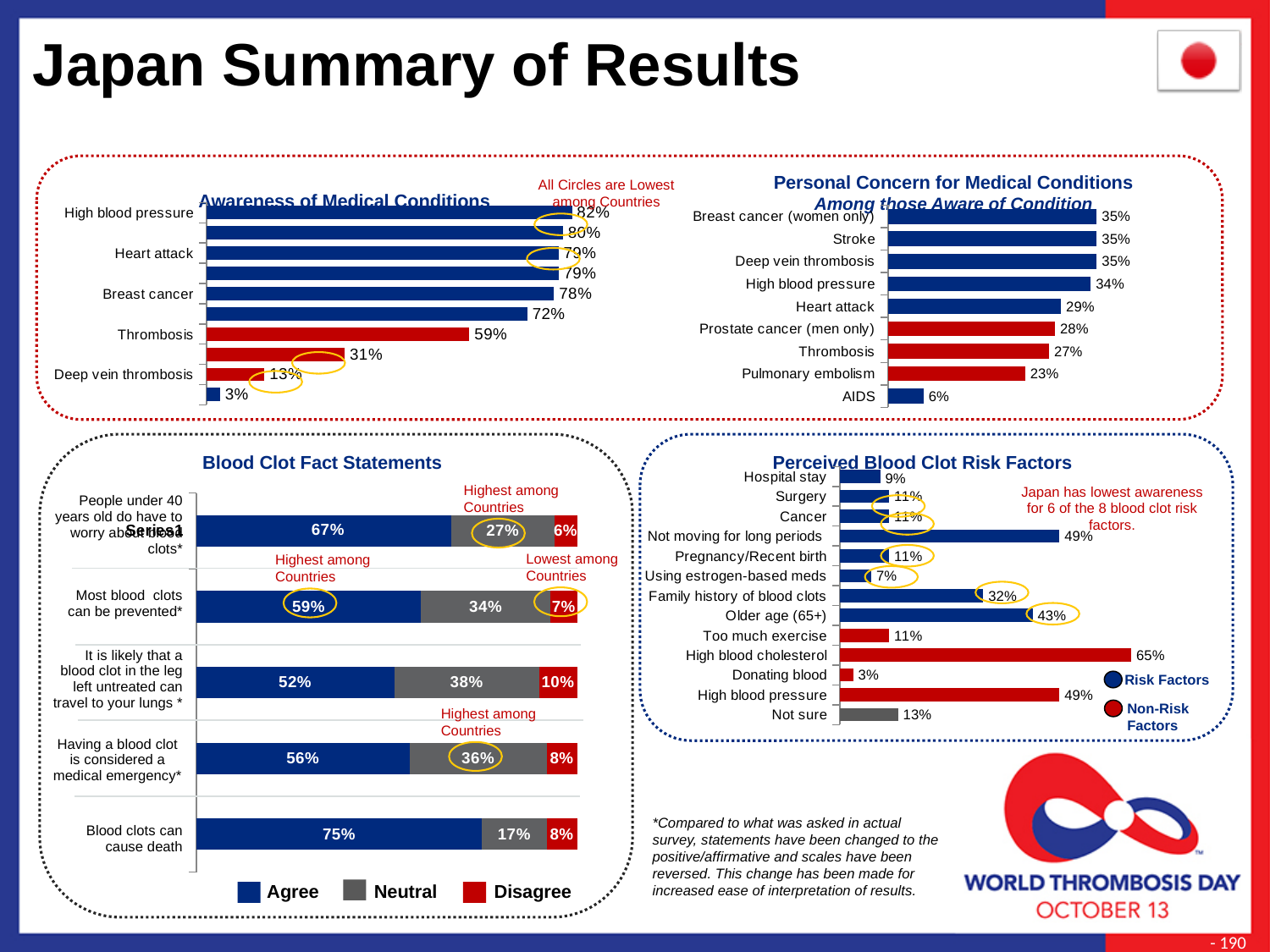
In the Personal Concern for Medical Conditions chart, how many categories are shown? 9 In the Personal Concern for Medical Conditions chart, what is the value for AIDS? 6% In the Blood Clot Fact Statements chart, what is the Neutral value for 'Most blood clots can be prevented'? 34% In the Personal Concern for Medical Conditions chart, what is the value for Heart attack? 29% In the Perceived Blood Clot Risk Factors chart, what is the value for Older age (65+)? 43% In the Personal Concern for Medical Conditions chart, what is the difference between High blood pressure and Pulmonary embolism? 11% In the Blood Clot Fact Statements chart, what percentage agree that blood clots can cause death? 75% In the Blood Clot Fact Statements chart, how many series does the legend list? 3 In the Perceived Blood Clot Risk Factors chart, which is larger: Family history of blood clots or Not moving for long periods? Not moving for long periods In the Personal Concern for Medical Conditions chart, which category has the lowest value? AIDS What kind of chart is the Awareness of Medical Conditions chart? Bar chart In the Perceived Blood Clot Risk Factors chart, which category has the highest value? High blood cholesterol